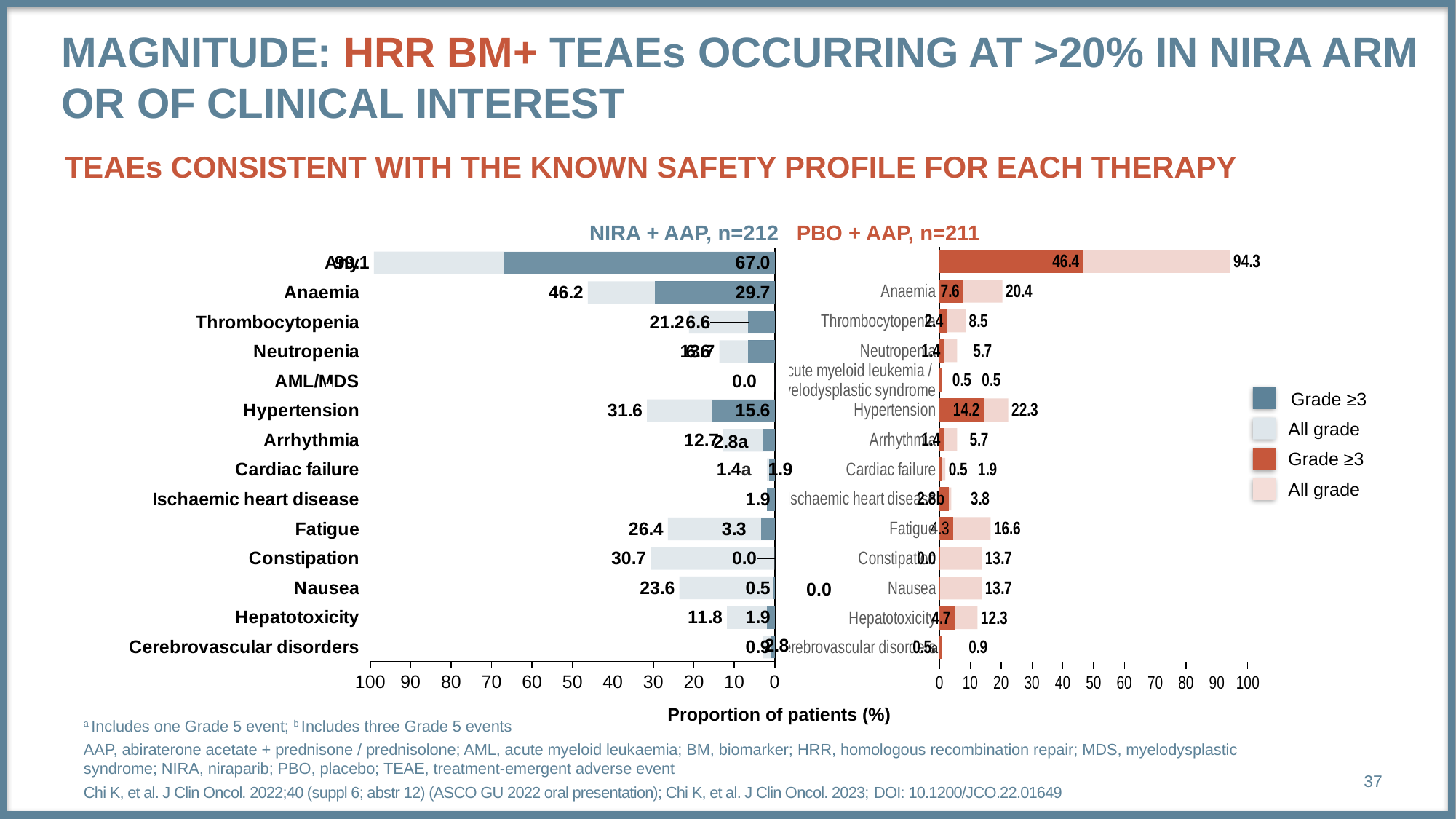
In the NIRA + AAP chart, what is the difference between the all-grade and Grade ≥3 proportions for anaemia? 16.5 How many series does the legend list in total across both charts? 4 In the NIRA + AAP chart, what is the all-grade proportion of patients with anaemia? 46.2 In the NIRA + AAP chart, what is the Grade ≥3 proportion of patients with hypertension? 15.6 What type of chart is used to show the TEAE proportions? Bar chart In the NIRA + AAP chart, which specific TEAE (excluding 'Any') has the highest all-grade proportion? Anaemia In the PBO + AAP chart, which specific TEAE (excluding 'Any') has the highest Grade ≥3 proportion? Hypertension How many TEAE categories are listed in the NIRA + AAP chart? 14 Which arm has the higher all-grade proportion of patients with constipation, NIRA + AAP or PBO + AAP? NIRA + AAP In the PBO + AAP chart, what is the difference between the all-grade and Grade ≥3 proportions for hypertension? 8.1 In the PBO + AAP chart, what is the all-grade proportion of patients with fatigue? 16.6 In the PBO + AAP chart, what is the Grade ≥3 proportion of patients with anaemia? 7.6